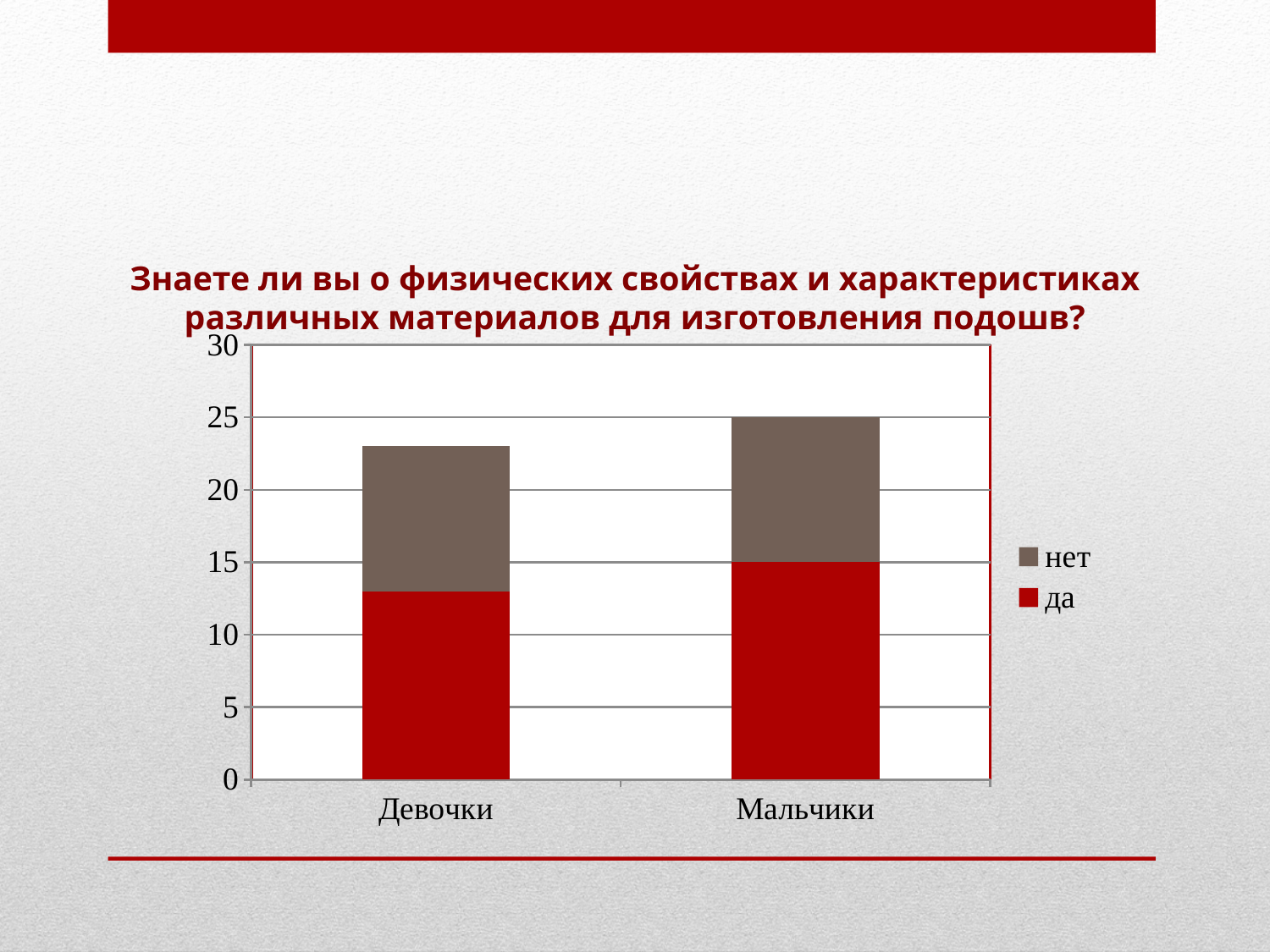
What is the total height of the stacked bar for Мальчики? 25 What kind of chart is shown on the slide? bar chart Which series is shown in red in the chart? да What are the two entries listed in the chart legend? нет, да Is the total height of the stacked bar for Девочки greater or less than 20? greater How many categories are shown on the x axis of the chart? 2 Is the value of the "да" series for Девочки greater or less than 15? less Which category has the larger "да" value, Девочки or Мальчики? Мальчики Is the total height of the stacked bar for Девочки greater or less than 25? less How many series does the chart legend list? 2 Which category has the taller stacked bar overall, Девочки or Мальчики? Мальчики What is the value of the "да" series for Мальчики? 15